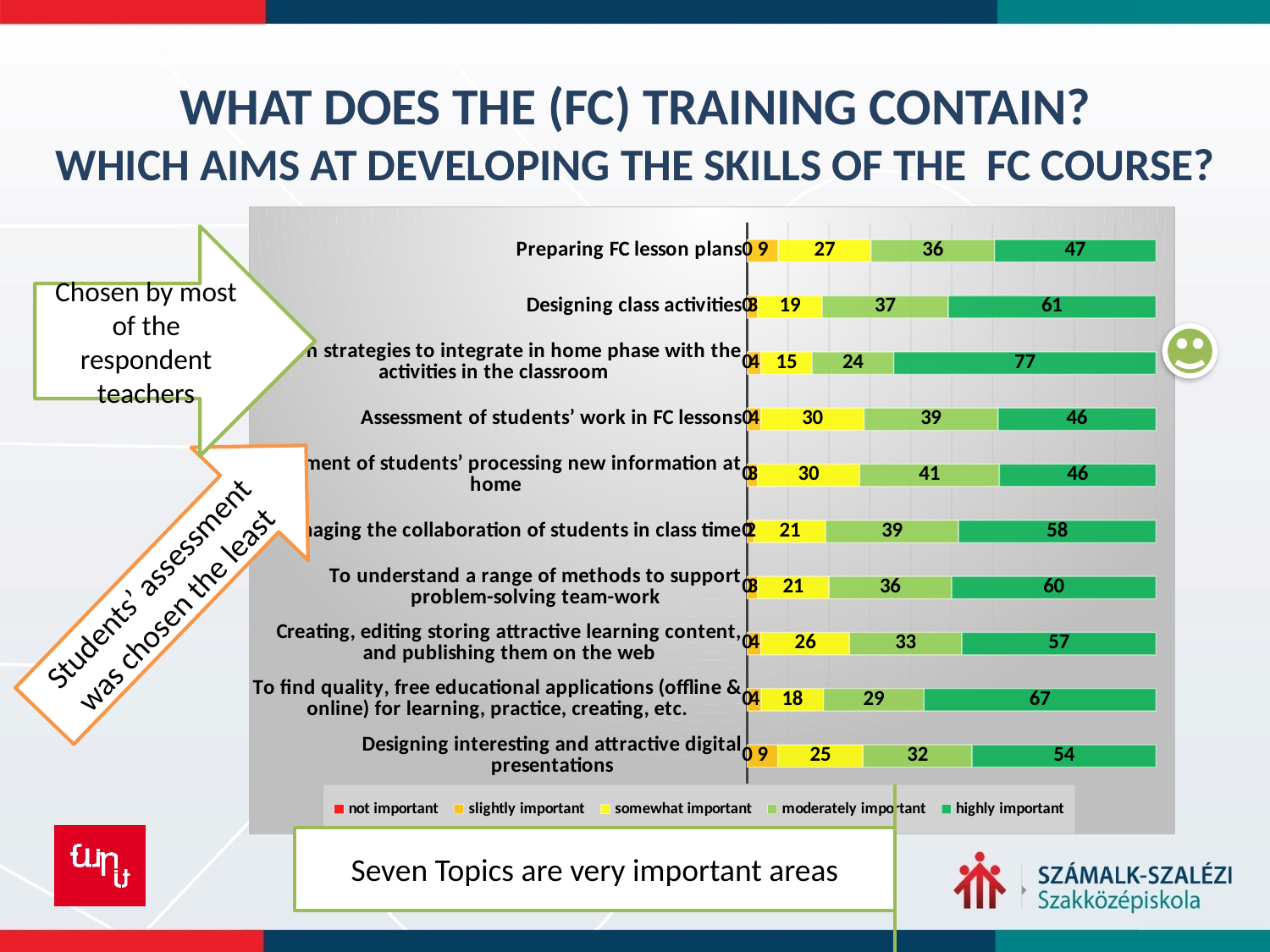
How many categories (bars) are shown in the chart? 10 Which has the larger 'moderately important' value: 'Creating, editing storing attractive learning content, and publishing them on the web' or 'To find quality, free educational applications (offline & online) for learning, practice, creating, etc.'? Creating, editing storing attractive learning content, and publishing them on the web What is the difference between the 'highly important' values for 'Designing class activities' and 'Preparing FC lesson plans'? 14 What is the 'highly important' value for 'To find quality, free educational applications (offline & online) for learning, practice, creating, etc.'? 67 What is the difference between the 'somewhat important' values for 'Preparing FC lesson plans' and 'Designing class activities'? 8 Which has the larger 'highly important' value: 'Designing class activities' or 'Preparing FC lesson plans'? Designing class activities What is the 'somewhat important' value for 'Assessment of students' work in FC lessons'? 30 What is the 'moderately important' value for 'Designing class activities'? 37 How many series does the legend list? 5 What is the 'highly important' value for 'Preparing FC lesson plans'? 47 What kind of chart is shown on the slide? Stacked bar chart What is the 'somewhat important' value for 'Designing interesting and attractive digital presentations'? 25